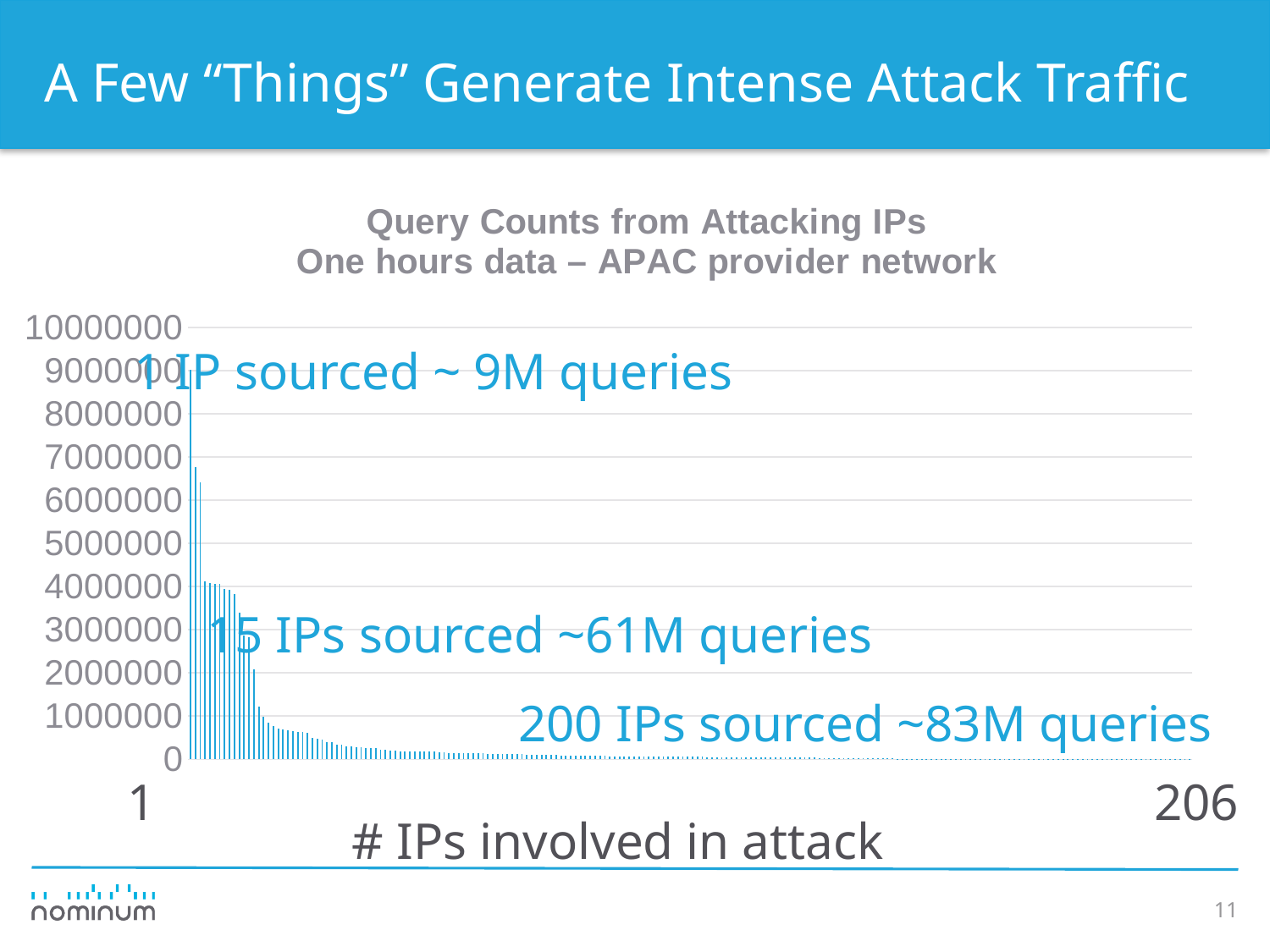
What kind of chart is shown on the slide? bar chart Which IP has the highest query count, the first or the last? the first What is the last x-axis value shown, i.e. how many IPs are plotted? 206 What is the title of the chart? Query Counts from Attacking IPs One hours data – APAC provider network Do the query counts rise or fall as you move along the x axis from IP 1 to IP 206? fall What is the label of the x axis? # IPs involved in attack Is the query count for IP 1 larger than the query count for IP 2? yes Is the query count for the first IP greater or less than 8000000? greater Is the query count for the last IP (206) greater or less than 1000000? less What is the highest value shown on the y axis? 10000000